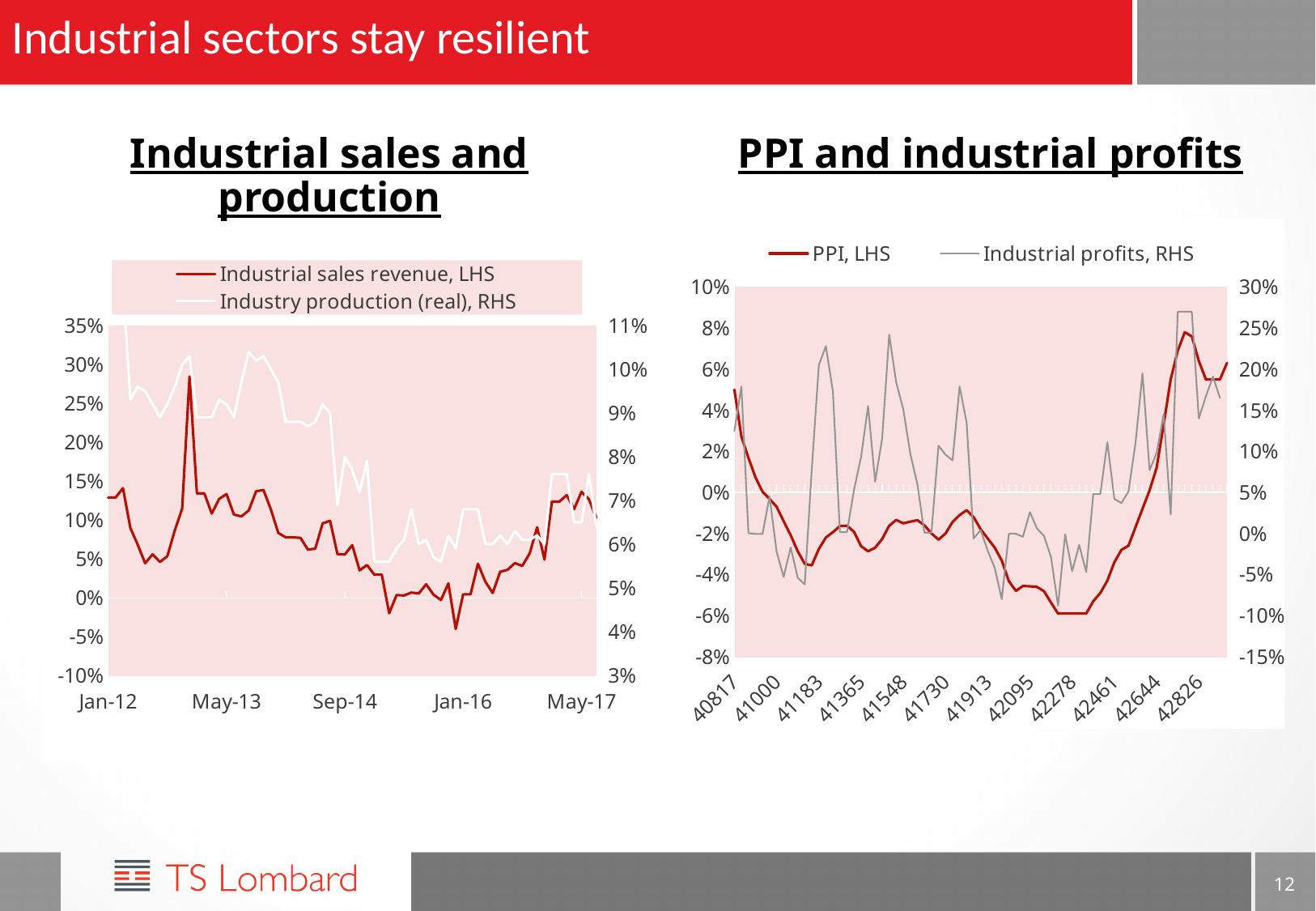
How many series does the legend of the 'PPI and industrial profits' chart list? 2 How many tick labels are shown on the x axis of the 'PPI and industrial profits' chart? 12 In the 'Industrial sales and production' chart, which series is plotted on the right-hand axis according to the legend? Industry production (real), RHS How many series does the legend of the 'Industrial sales and production' chart list? 2 In the 'PPI and industrial profits' chart, which series is drawn in red according to the legend? PPI, LHS What kind of chart is the 'PPI and industrial profits' chart? line chart In the 'Industrial sales and production' chart, is the peak value of Industrial sales revenue around May-13 greater or less than 25%? greater In the 'PPI and industrial profits' chart, is the peak value of Industrial profits on the right-hand axis greater or less than 25%? greater In the 'PPI and industrial profits' chart, is the lowest value of PPI greater or less than -4%? less What kind of chart is the 'Industrial sales and production' chart? line chart In the 'PPI and industrial profits' chart, does PPI rise or fall between 42278 and 42826? rise